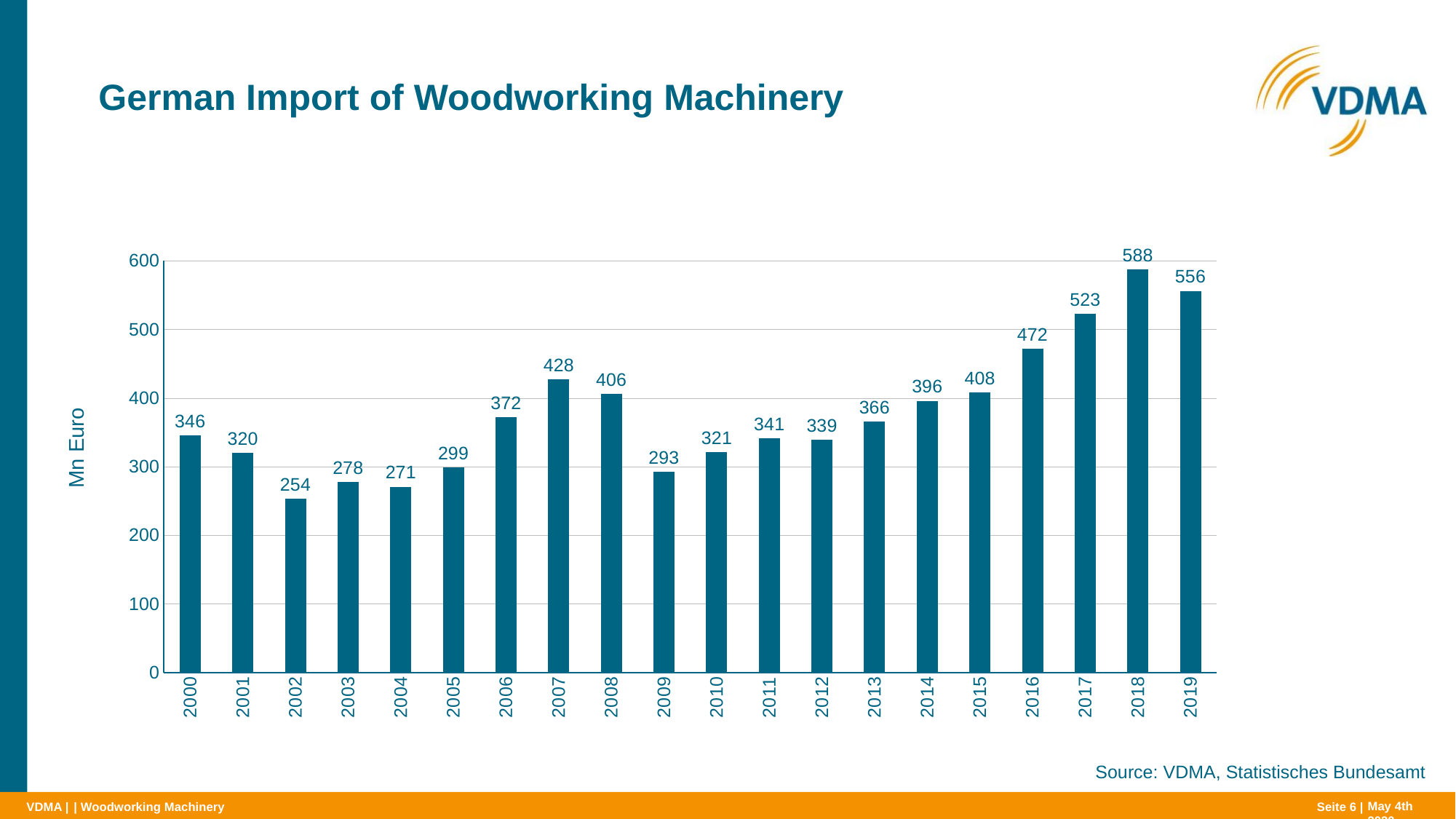
What is the value for 2019? 556 What is the difference between the values for 2018 and 2019? 32 What is the label of the y axis? Mn Euro Which year has the highest value? 2018 Which is larger, the value for 2006 or the value for 2013? 2006 Is the value for 2016 greater or less than 500? less What is the value for 2007? 428 What kind of chart is shown on the slide? bar chart What is the value for 2002? 254 Which year has the lowest value? 2002 How many years are shown on the x axis? 20 What is the difference between the values for 2008 and 2009? 113